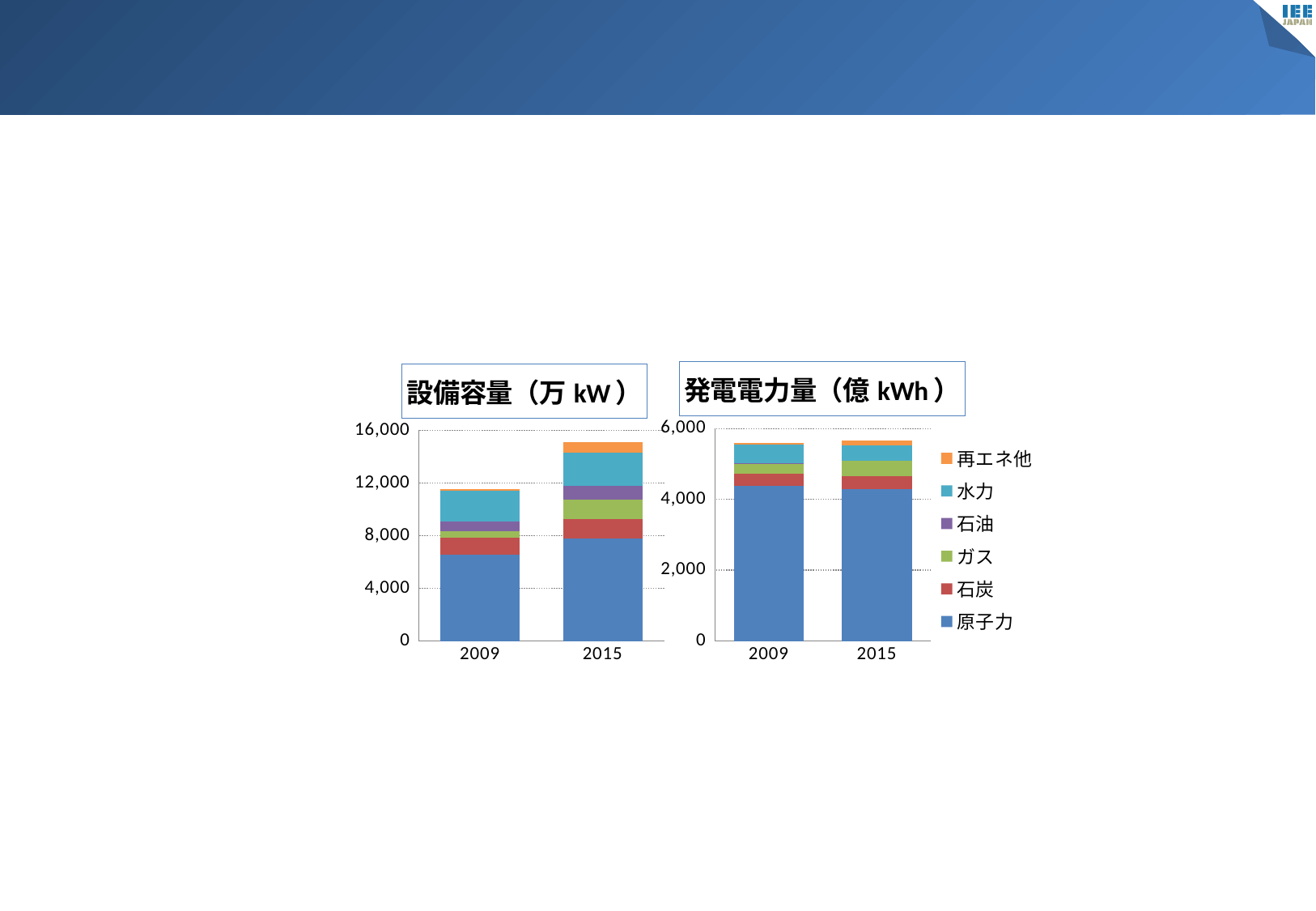
What kind of chart is the 設備容量（万 kW） chart? stacked bar chart In the 設備容量（万 kW） chart, is the 原子力 value for 2009 greater or less than 8,000? less In the 発電電力量（億 kWh） chart, is the total for 2009 greater or less than 4,000? greater What is the title of the chart on the right? 発電電力量（億 kWh） How many series does the legend list for the charts? 6 In the 設備容量（万 kW） chart, which year has the larger total, 2009 or 2015? 2015 In the 設備容量（万 kW） chart, is the total for 2015 greater or less than 12,000? greater How many categories are shown on the x axis of the 発電電力量（億 kWh） chart? 2 Which series is shown in orange in the legend? 再エネ他 In the 設備容量（万 kW） chart, does the total rise or fall from 2009 to 2015? rise